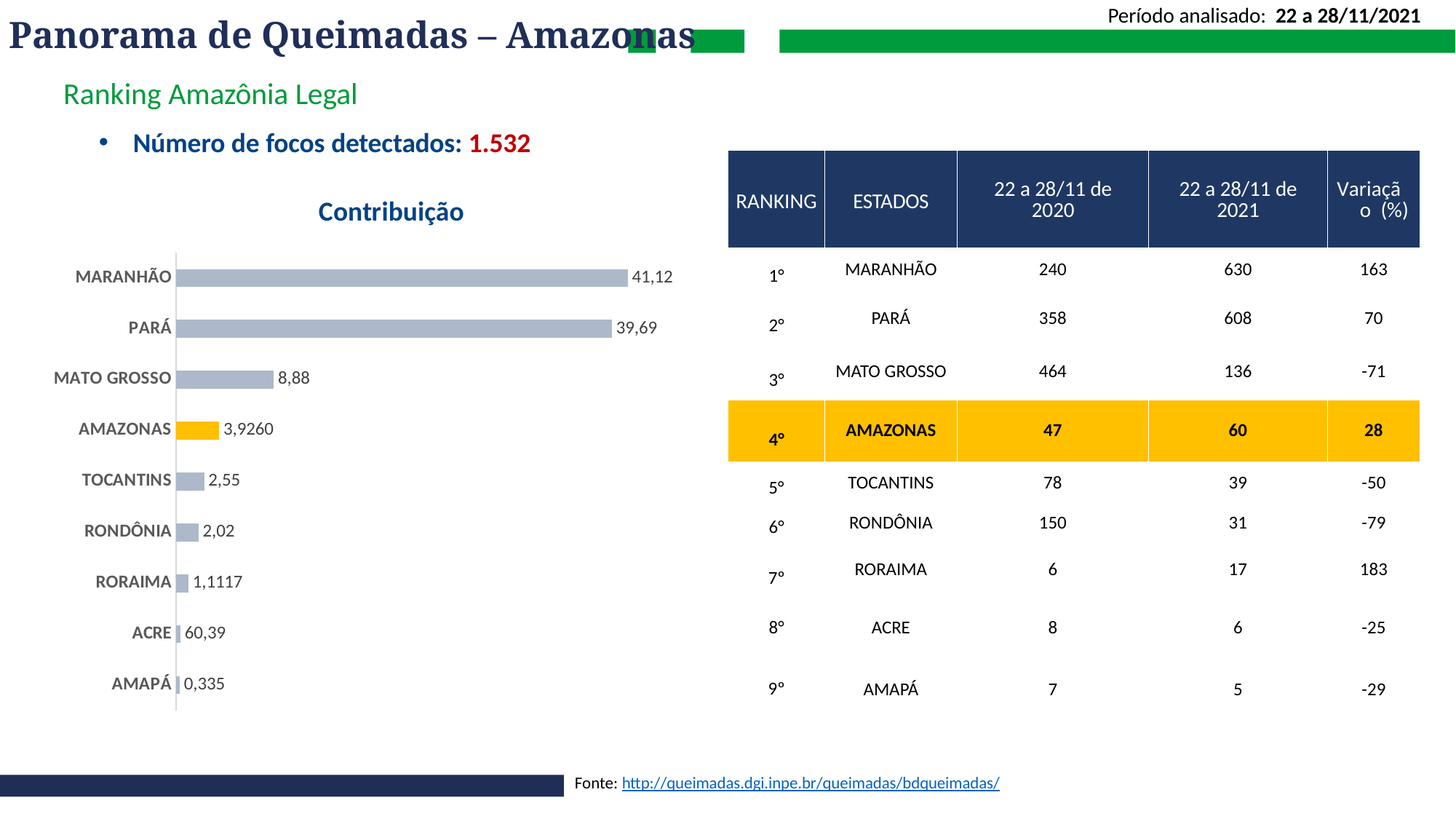
What kind of chart is the Contribuição chart? bar chart In the Contribuição chart, what is the value for RONDÔNIA? 2,02 In the Contribuição chart, what is the value for AMAZONAS? 3,9260 In the Contribuição chart, what is the value for MATO GROSSO? 8,88 In the Contribuição chart, what is the value for MARANHÃO? 41,12 In the Contribuição chart, what is the value for TOCANTINS? 2,55 In the Contribuição chart, what is the difference between the values for MARANHÃO and PARÁ? 1,43 How many states are shown in the Contribuição chart? 9 In the Contribuição chart, which state has the highest value? MARANHÃO In the Contribuição chart, which state's bar is highlighted in yellow? AMAZONAS In the Contribuição chart, which is larger, the value for MATO GROSSO or the value for TOCANTINS? MATO GROSSO In the Contribuição chart, what is the value for PARÁ? 39,69